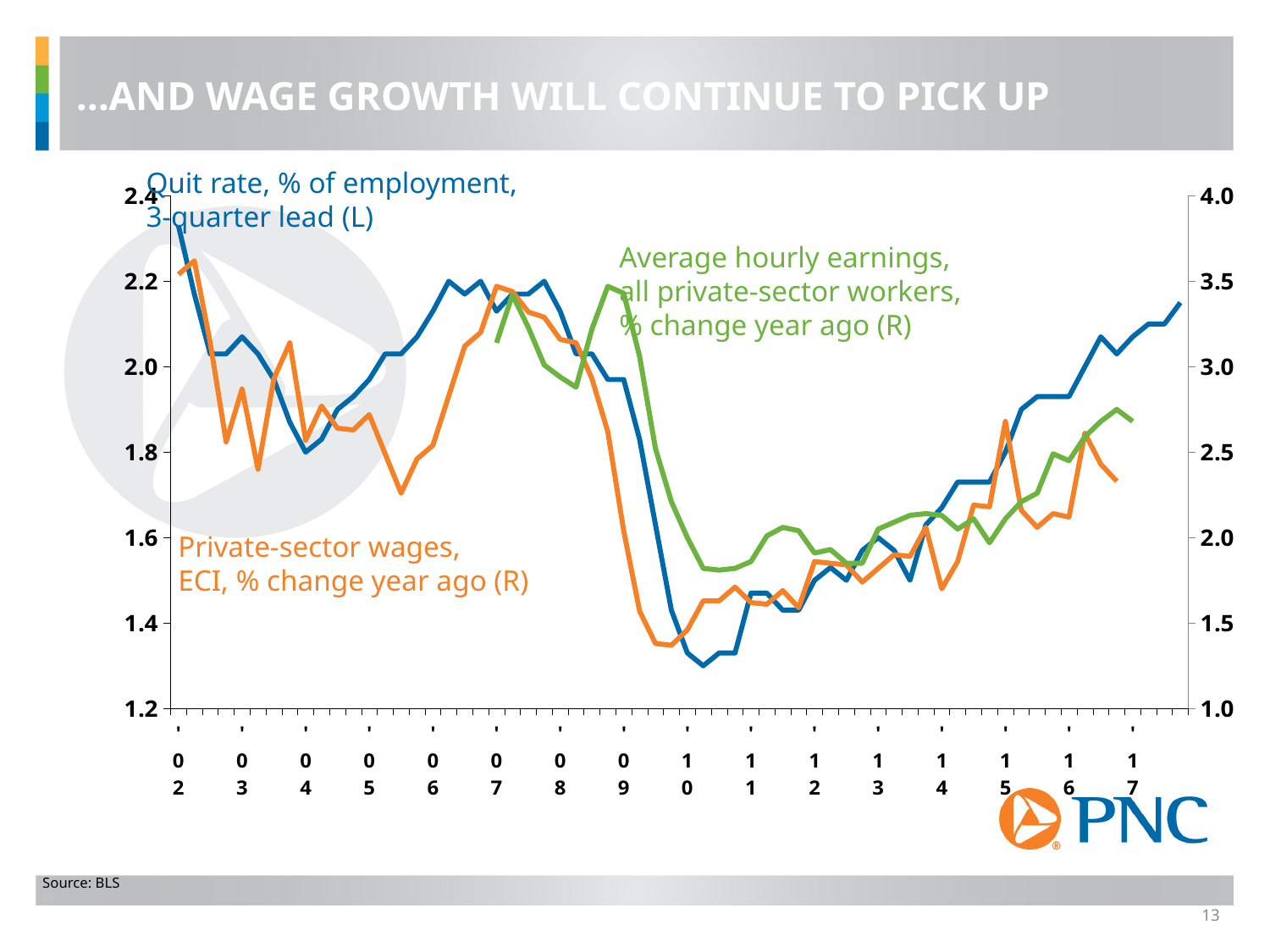
What is the source cited for the chart? BLS Is the private-sector wages (ECI) value at 2002 greater or less than 3.0? greater At 2010, which is higher: average hourly earnings or private-sector wages (ECI)? Average hourly earnings What kind of chart is shown on the slide? Line chart Is the quit rate value at 2016 greater or less than 1.8? greater How many data series are plotted on the chart? 3 Is the quit rate value at 2010 greater or less than 1.4? less In which year does the quit rate reach its lowest point? 2010 Which series is plotted against the left axis? Quit rate, % of employment, 3-quarter lead Does the quit rate rise or fall between 2010 and 2017? rise How many year labels are shown along the x axis? 16